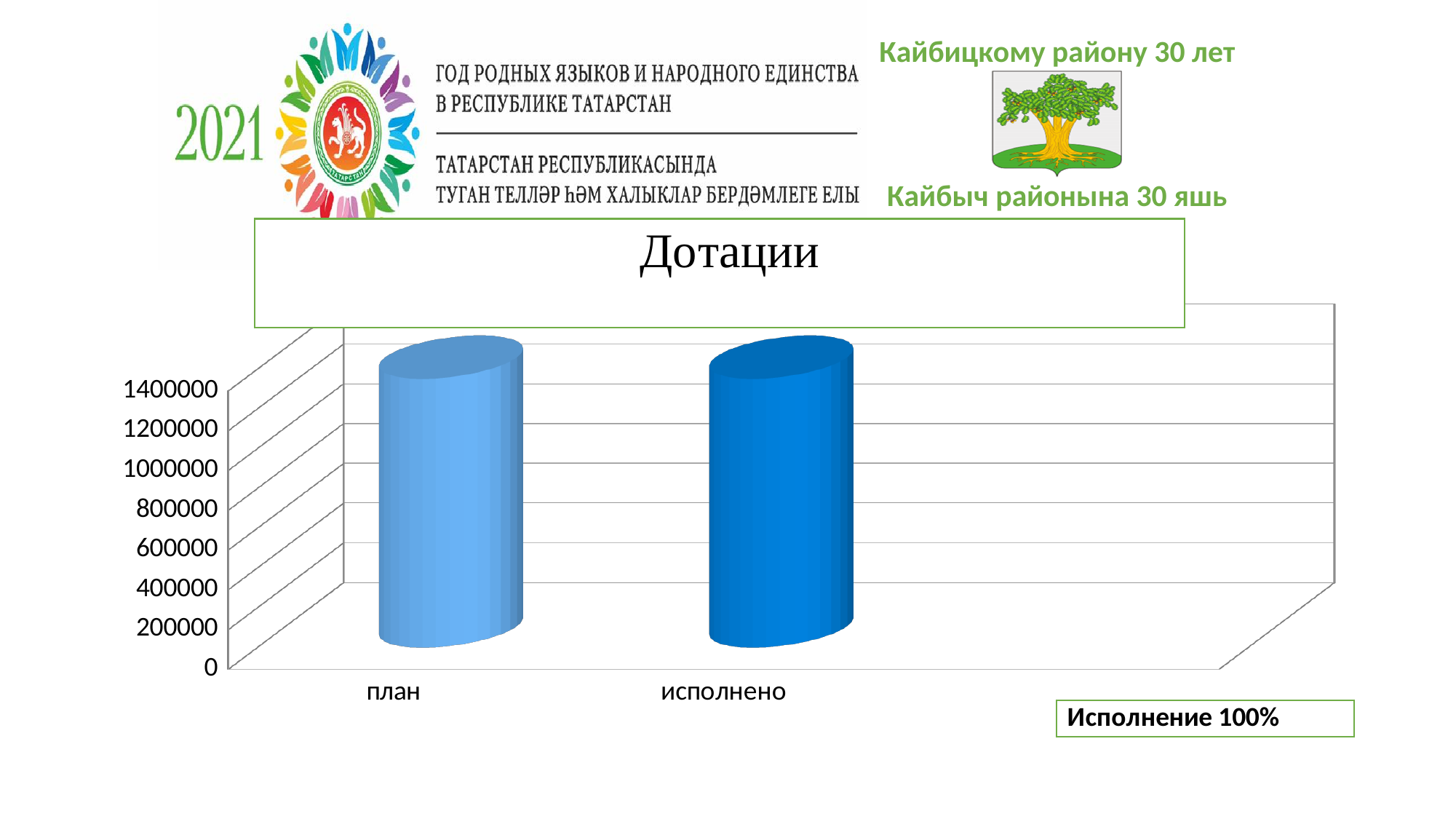
What is the highest tick value shown on the vertical axis? 1400000 Is the value for план greater or less than 800000? greater What is the label of the first category on the x axis? план What kind of chart is shown on the slide? bar chart Is the value for исполнено greater or less than 1000000? greater Is the value for план greater or less than 1000000? greater What is the title of the chart? Дотации How many categories are shown on the x axis of the chart? 2